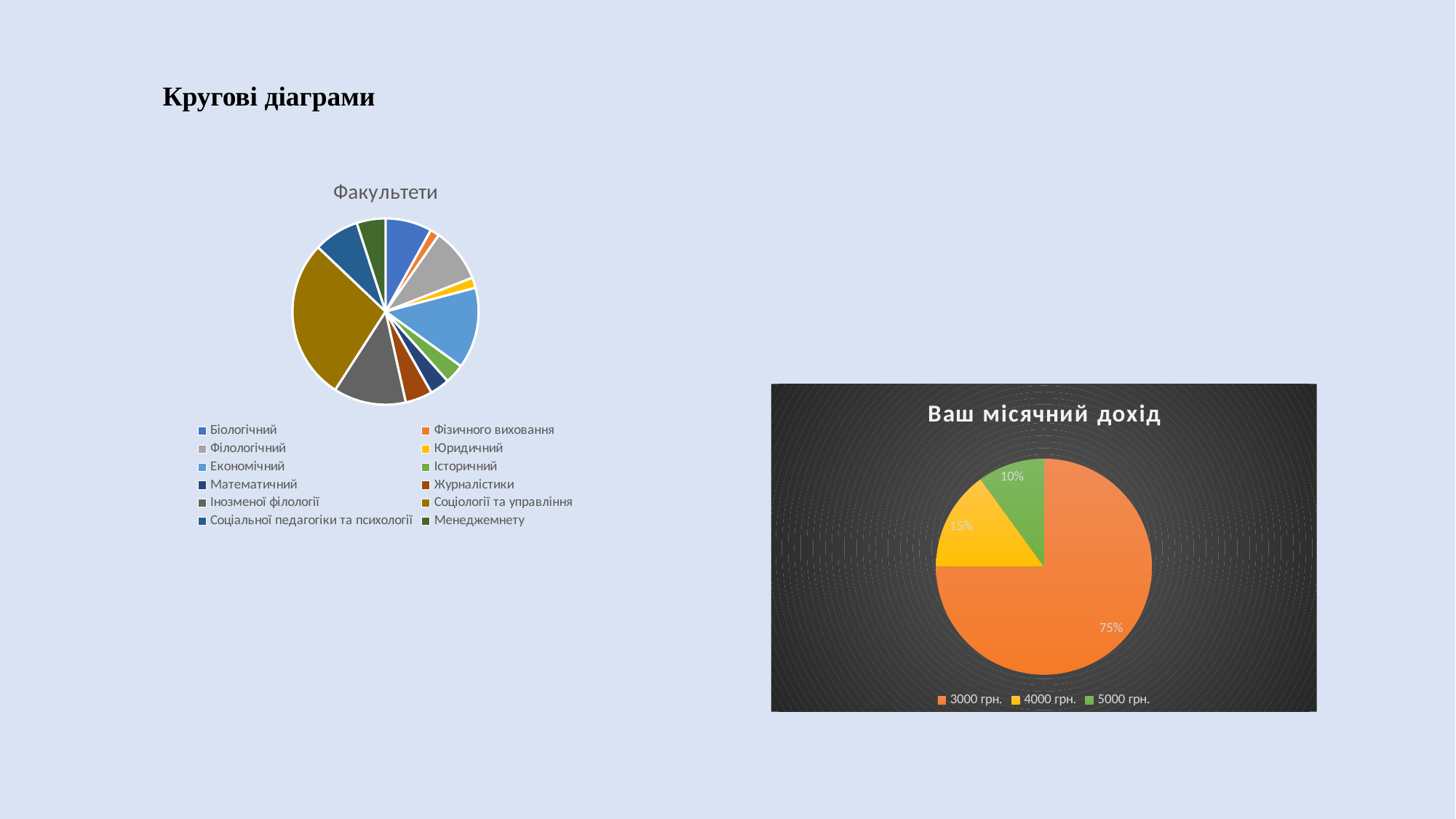
In the chart titled "Факультети", how many categories does the legend list? 12 In the chart titled "Ваш місячний дохід", what share is shown for 5000 грн.? 10% What kind of chart is the chart titled "Ваш місячний дохід"? Pie chart In the chart titled "Факультети", which slice is larger: Економічний or Історичний? Економічний In the chart titled "Ваш місячний дохід", which is larger: the 4000 грн. slice or the 5000 грн. slice? 4000 грн. In the chart titled "Ваш місячний дохід", what share is shown for 3000 грн.? 75% In the chart titled "Ваш місячний дохід", how many categories does the legend list? 3 In the chart titled "Ваш місячний дохід", which category has the largest slice? 3000 грн. In the chart titled "Ваш місячний дохід", what share is shown for 4000 грн.? 15% In the chart titled "Ваш місячний дохід", what is the difference in percentage points between the 3000 грн. slice and the 4000 грн. slice? 60 In the chart titled "Ваш місячний дохід", which category has the smallest slice? 5000 грн. In the chart titled "Факультети", which category has the largest slice? Соціології та управління